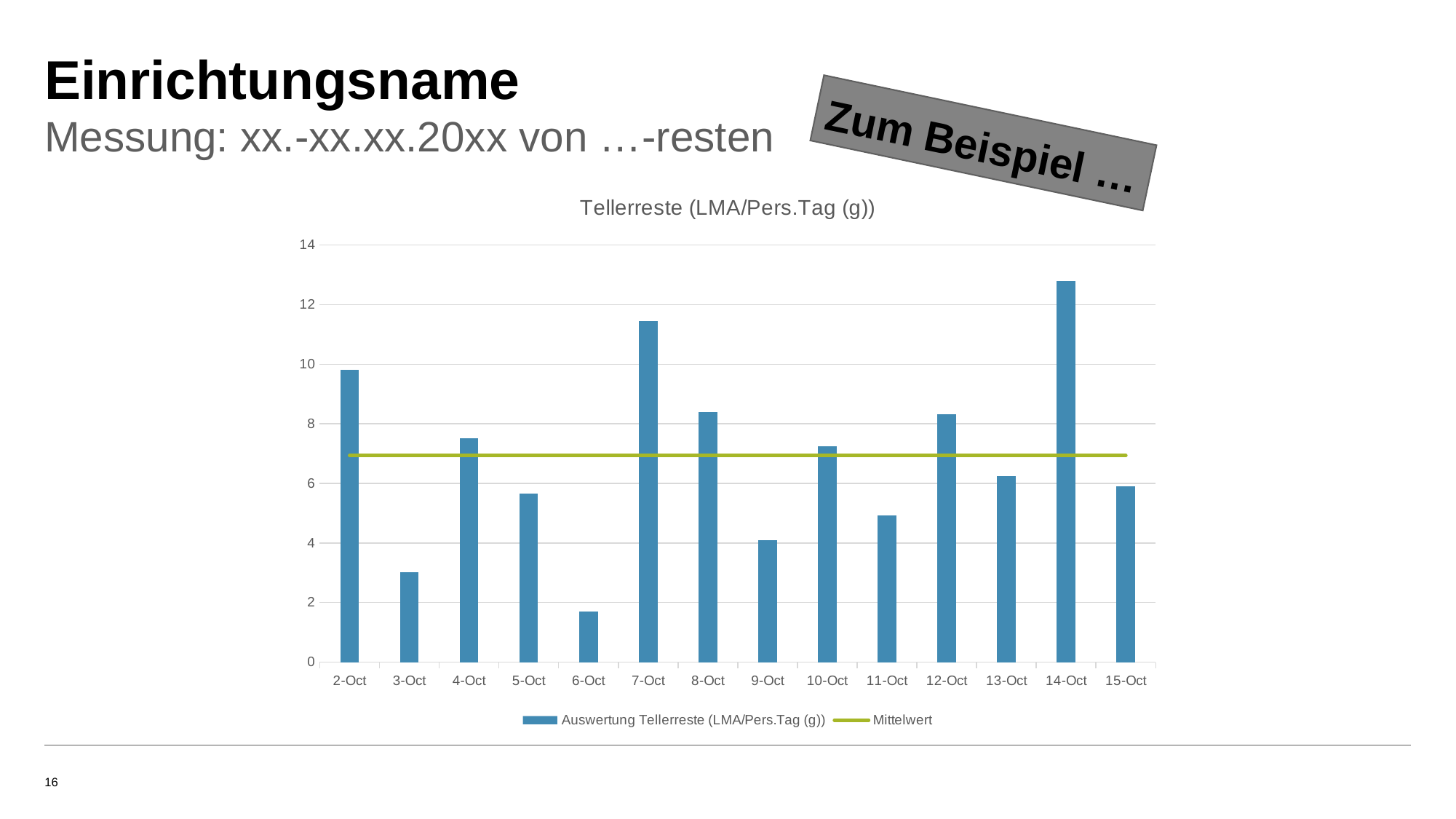
What kind of chart is shown on the slide? Combination bar and line chart How many series does the chart legend list? 2 How many dates are shown on the x axis of the chart? 14 Is the value for 7-Oct greater or less than 10? greater Which has the larger value, 7-Oct or 8-Oct? 7-Oct What is the title of the chart? Tellerreste (LMA/Pers.Tag (g)) Is the value for 14-Oct greater or less than 12? greater What is the name of the line series shown in the legend? Mittelwert Is the value for 11-Oct greater or less than 6? less Which date has the lowest bar in the chart? 6-Oct Which date has the highest bar in the chart? 14-Oct